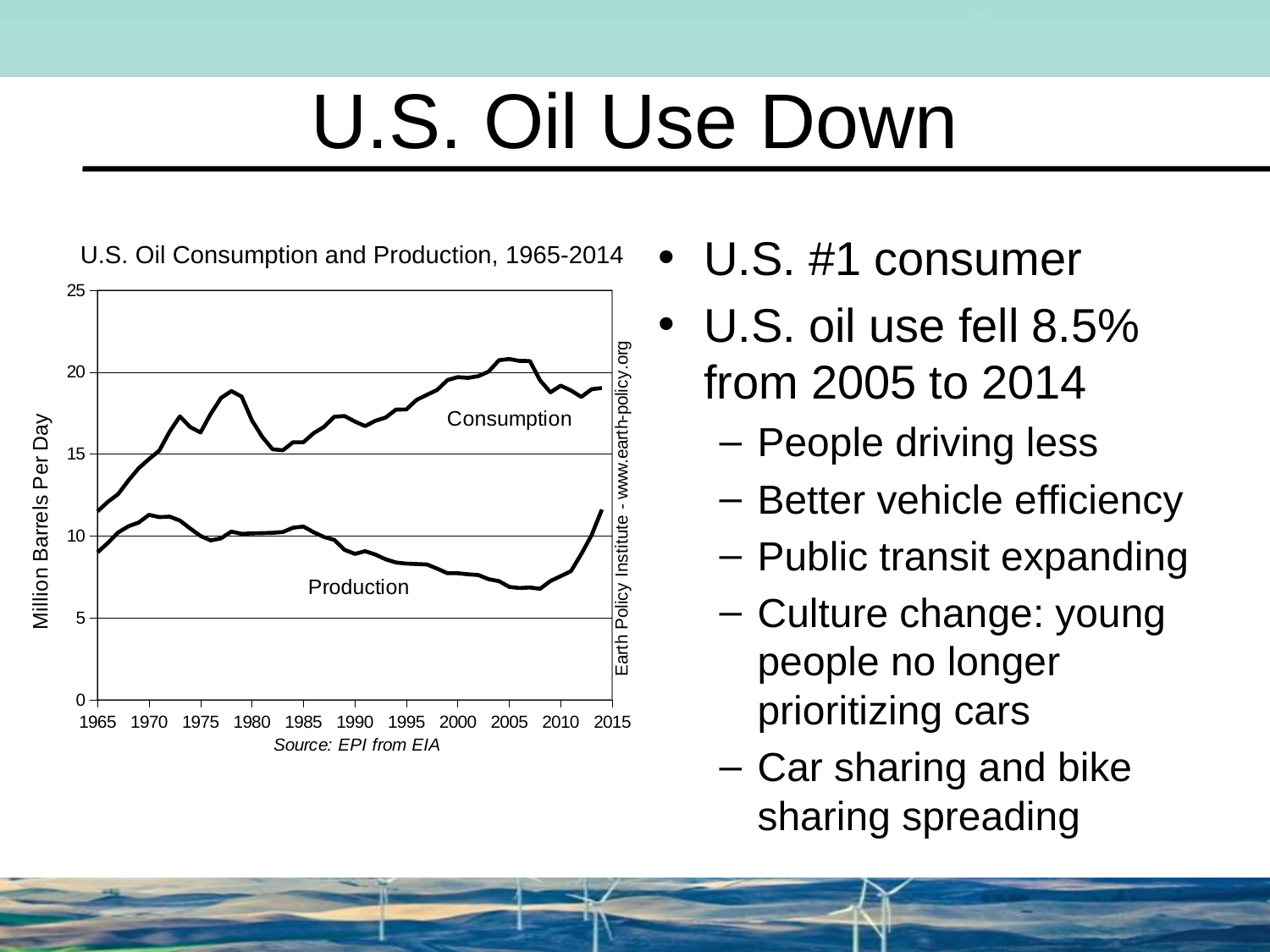
What is the label on the vertical axis of the chart? Million Barrels Per Day What kind of chart is shown on the slide? line chart Is the value for Consumption in 1995 greater or less than 15? greater Is the value for Production in 2014 greater or less than 10? greater Does the Production line rise or fall between 1985 and 2008? fall Is the value for Production in 1970 greater or less than 10? greater Does the Consumption line rise or fall between 1965 and 1978? rise What is the title of the chart? U.S. Oil Consumption and Production, 1965-2014 How many series are plotted on the chart? 2 In 2005, which series has the larger value, Consumption or Production? Consumption